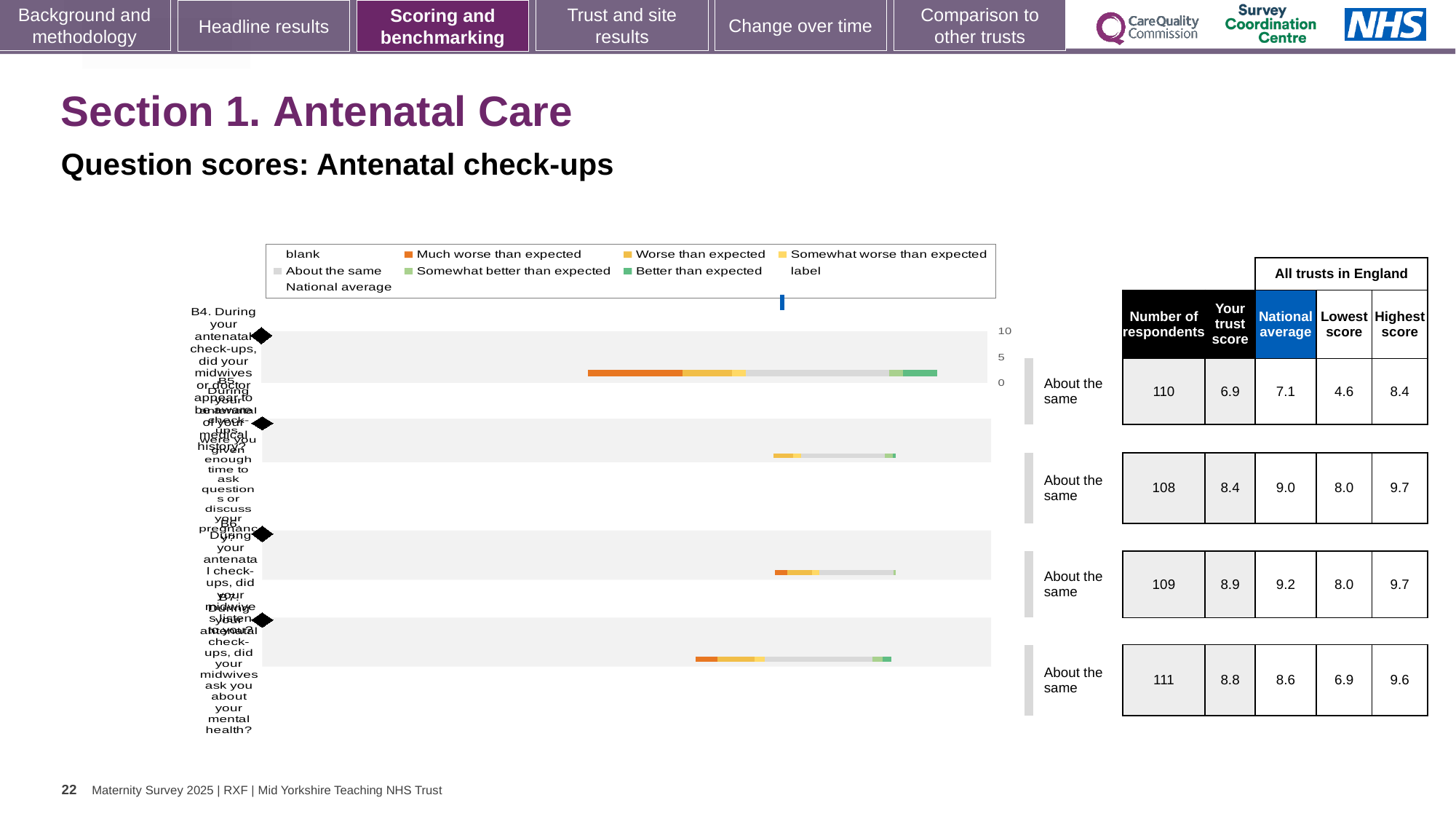
In the table beside the chart, what is 'Your trust score' for the first row (B4)? 6.9 What kind of chart is shown on the slide? bar chart For the first row (B4), which is larger: Your trust score or the National average? National average How many question bars are plotted in the chart? 4 In the table beside the chart, what is the Highest score for the second row (B5)? 9.7 What is the highest tick value shown on the chart's score axis? 10 In the table beside the chart, what is the National average for the first row (B4)? 7.1 In the table beside the chart, what is the Number of respondents for the fourth row (B7)? 111 For the fourth row (B7), what is the difference between Your trust score and the National average? 0.2 In the chart legend, what colour represents 'Much worse than expected'? orange Which row has the highest 'Your trust score' in the table beside the chart? third row (B6)